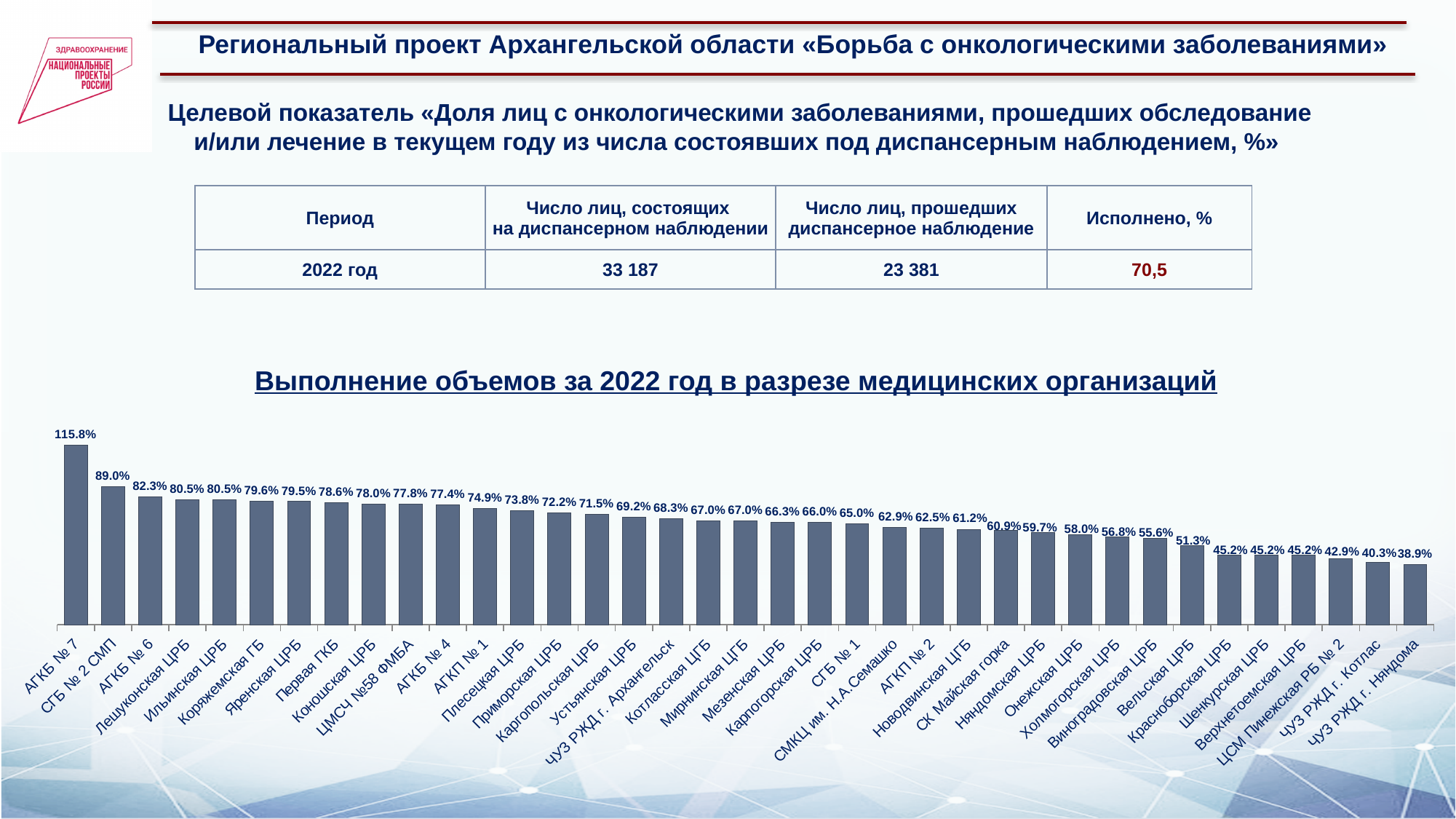
How many medical organisations are shown on the chart? 37 Which medical organisation has the highest value? АГКБ № 7 What is the value for Вельская ЦРБ? 51.3% What is the value for АГКБ № 7? 115.8% What is the value for Котласская ЦГБ? 67.0% What kind of chart is shown on the slide? Bar chart Which medical organisation has the lowest value? ЧУЗ РЖД г. Няндома Which is larger, the value for Плесецкая ЦРБ or the value for Новодвинская ЦГБ? Плесецкая ЦРБ What is the difference between the values for АГКБ № 7 and СГБ № 2 СМП? 26.8% Do the values rise or fall from left to right along the x axis? Fall What is the title of the chart? Выполнение объемов за 2022 год в разрезе медицинских организаций What is the difference between the values for Онежская ЦРБ and ЧУЗ РЖД г. Котлас? 17.7%